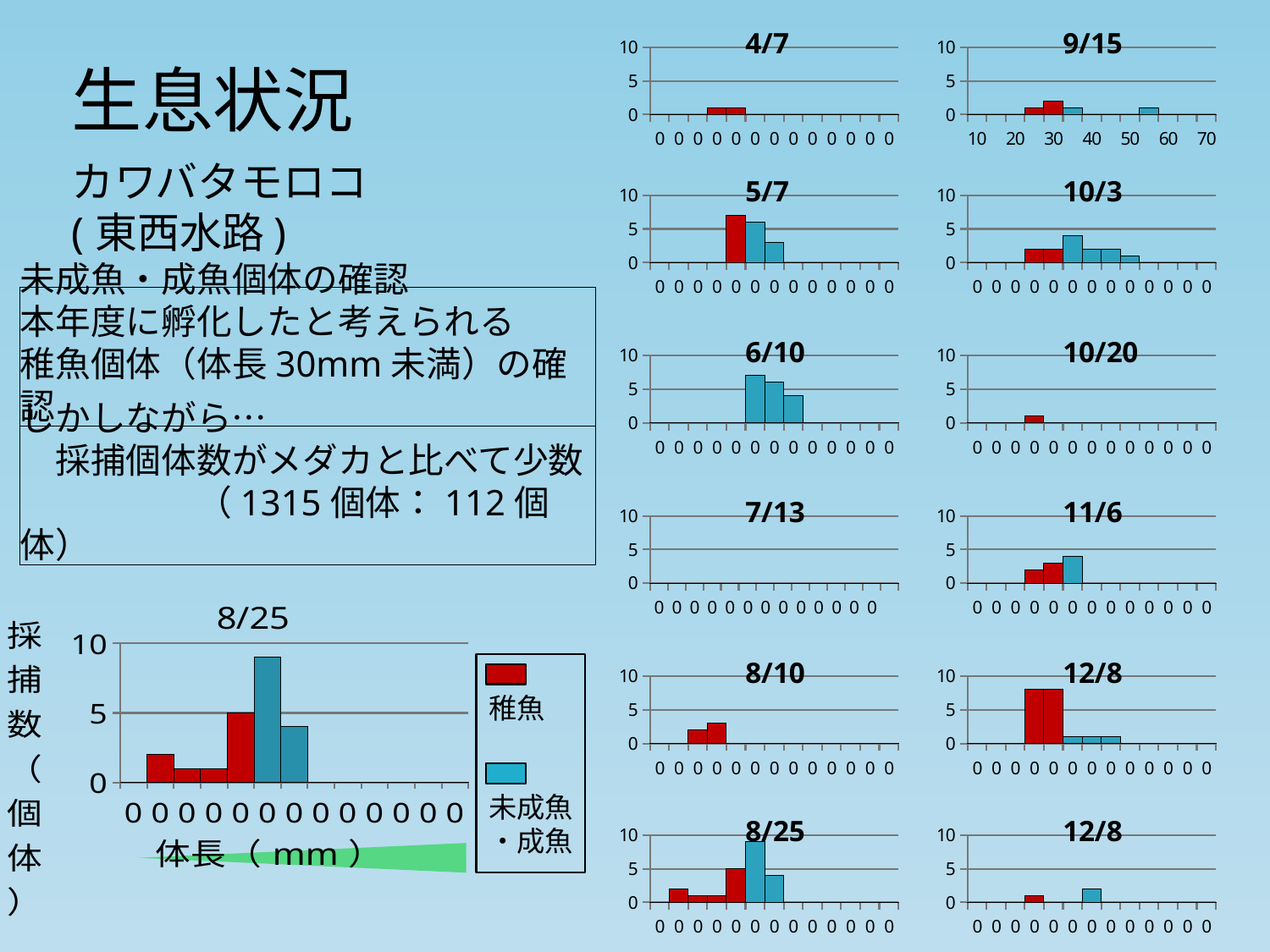
In the upper 12/8 chart, which series has the taller bars, 稚魚 or 未成魚・成魚? 稚魚 In the large 8/25 chart, which series has the tallest bar, 稚魚 or 未成魚・成魚? 未成魚・成魚 In the large 8/25 chart, is the tallest bar greater or less than 5? greater How many bars are plotted in the large 8/25 chart? 6 In the legend next to the 8/25 chart, which series is shown in blue? 未成魚・成魚 In the legend next to the 8/25 chart, which series is shown in red? 稚魚 How many bars are plotted in the 6/10 chart? 3 In the 10/3 chart, is the tallest bar greater or less than 5? less In the 4/7 chart, is the value of the single bar greater or less than 5? less How many series does the legend next to the 8/25 chart list? 2 What kind of chart is the large 8/25 chart at the bottom left of the slide? bar chart